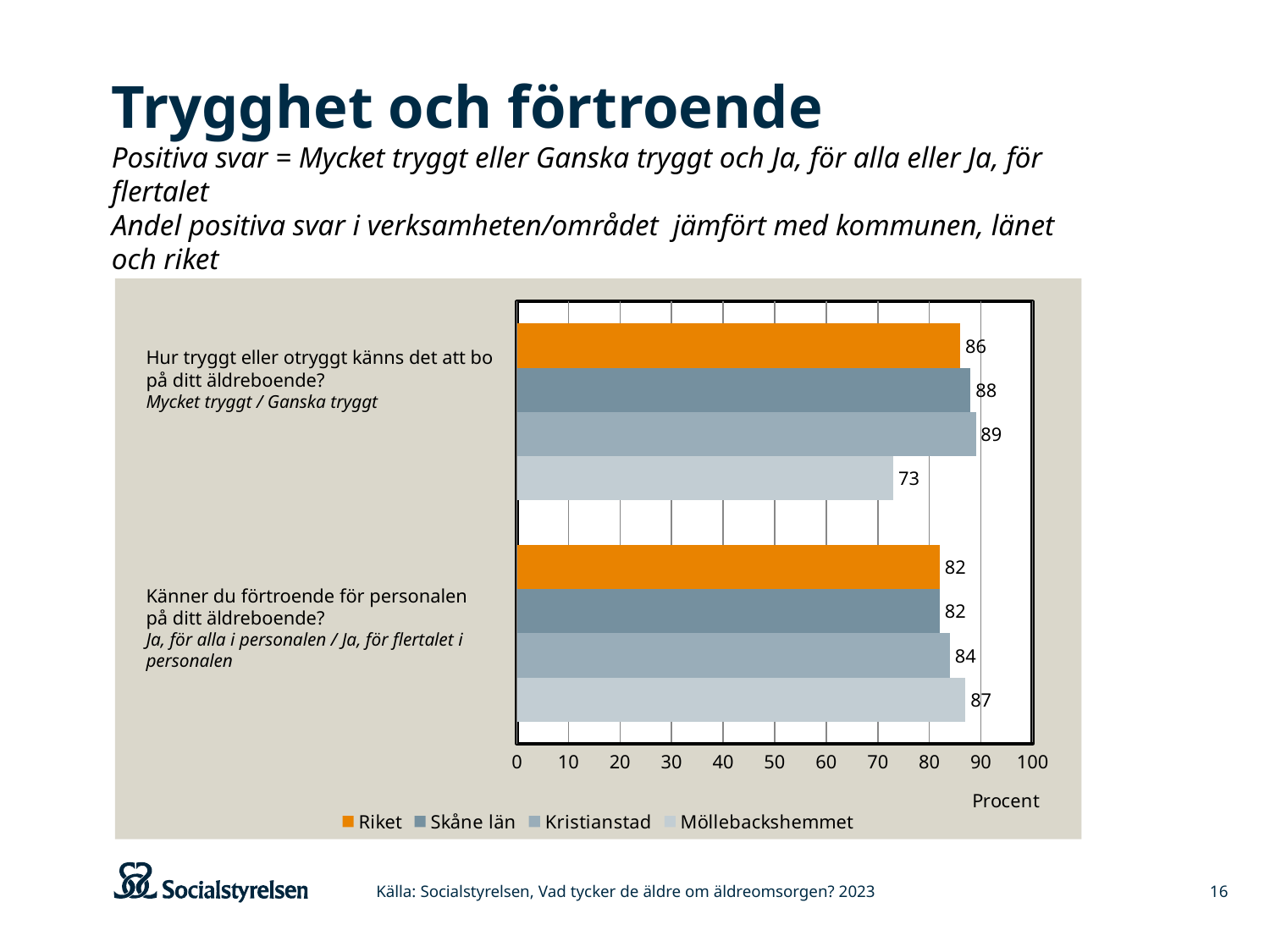
What is the value for Kristianstad on the question "Hur tryggt eller otryggt känns det att bo på ditt äldreboende?"? 89 What is the value for Möllebackshemmet on the question "Hur tryggt eller otryggt känns det att bo på ditt äldreboende?"? 73 What is the value for Riket on the question "Känner du förtroende för personalen på ditt äldreboende?"? 82 What unit label is shown below the x axis of the chart? Procent Which series has the highest value on the question "Känner du förtroende för personalen på ditt äldreboende?"? Möllebackshemmet Which series has the lowest value on the question "Hur tryggt eller otryggt känns det att bo på ditt äldreboende?"? Möllebackshemmet What is the value for Möllebackshemmet on the question "Känner du förtroende för personalen på ditt äldreboende?"? 87 What type of chart is shown on the slide? bar chart Is the value for Möllebackshemmet on the question "Känner du förtroende för personalen på ditt äldreboende?" larger or smaller than the value for Skåne län on the same question? larger Which series has the highest value on the question "Hur tryggt eller otryggt känns det att bo på ditt äldreboende?"? Kristianstad How many series does the legend list? 4 What is the difference between the Kristianstad and Möllebackshemmet values on the question "Hur tryggt eller otryggt känns det att bo på ditt äldreboende?"? 16